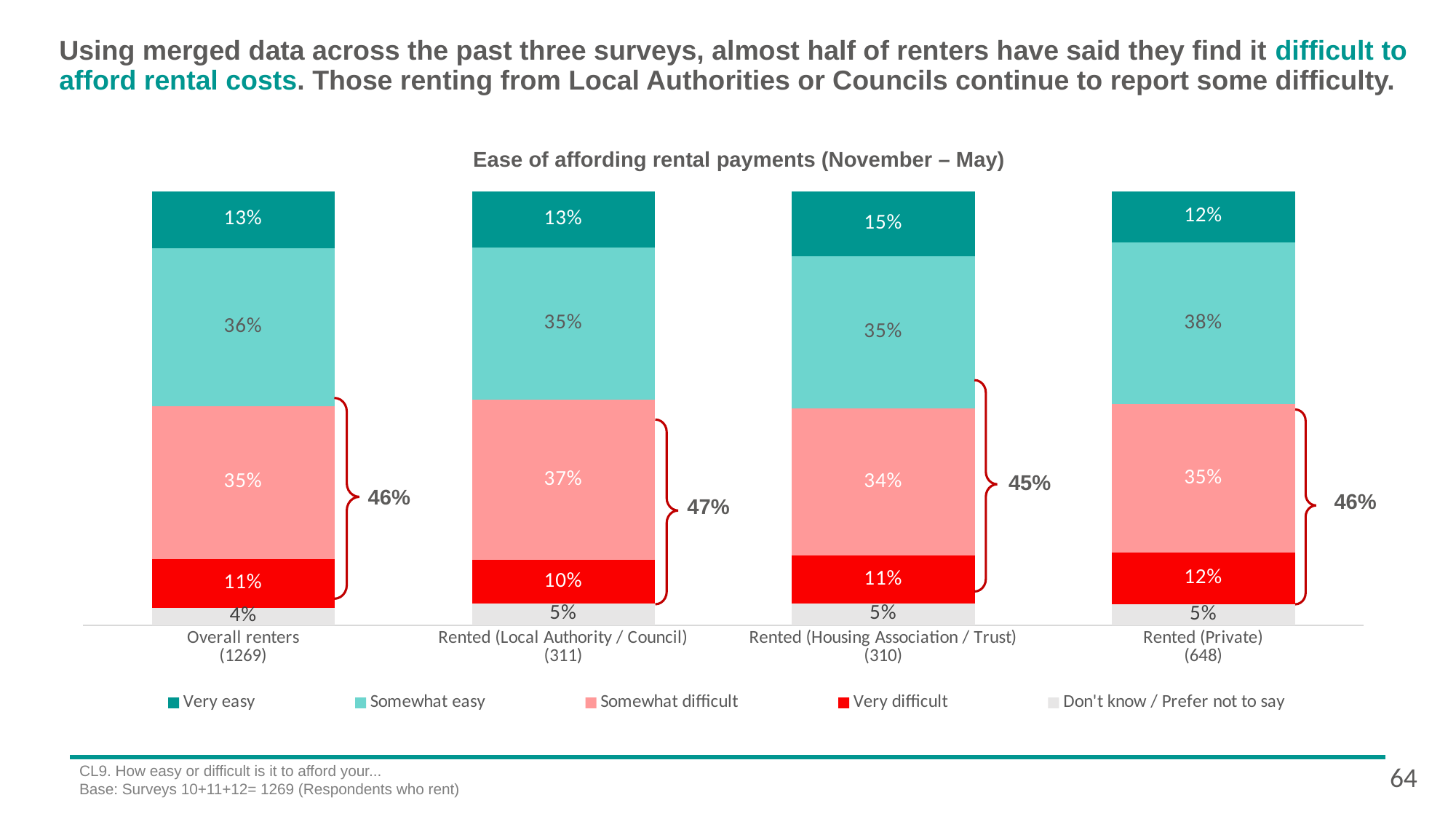
What percentage of Rented (Private) respondents said it is Very difficult? 12% Which is larger: the Somewhat difficult share for Rented (Local Authority / Council) or for Rented (Housing Association / Trust)? Rented (Local Authority / Council) What kind of chart is shown on the slide? Stacked bar chart Which category has the highest share of Very easy responses? Rented (Housing Association / Trust) What percentage of Rented (Local Authority / Council) respondents said it is Somewhat difficult? 37% How many percentage points higher is the Somewhat easy share for Rented (Private) than for Overall renters? 2 What percentage of Overall renters said it is Somewhat easy to afford rental payments? 36% Which category has the lowest share of Very difficult responses? Rented (Local Authority / Council) How many renter categories are shown on the x axis? 4 What is the combined share of Somewhat difficult and Very difficult responses for Rented (Local Authority / Council)? 47% What is the title of the chart? Ease of affording rental payments (November – May) How many series does the legend list? 5